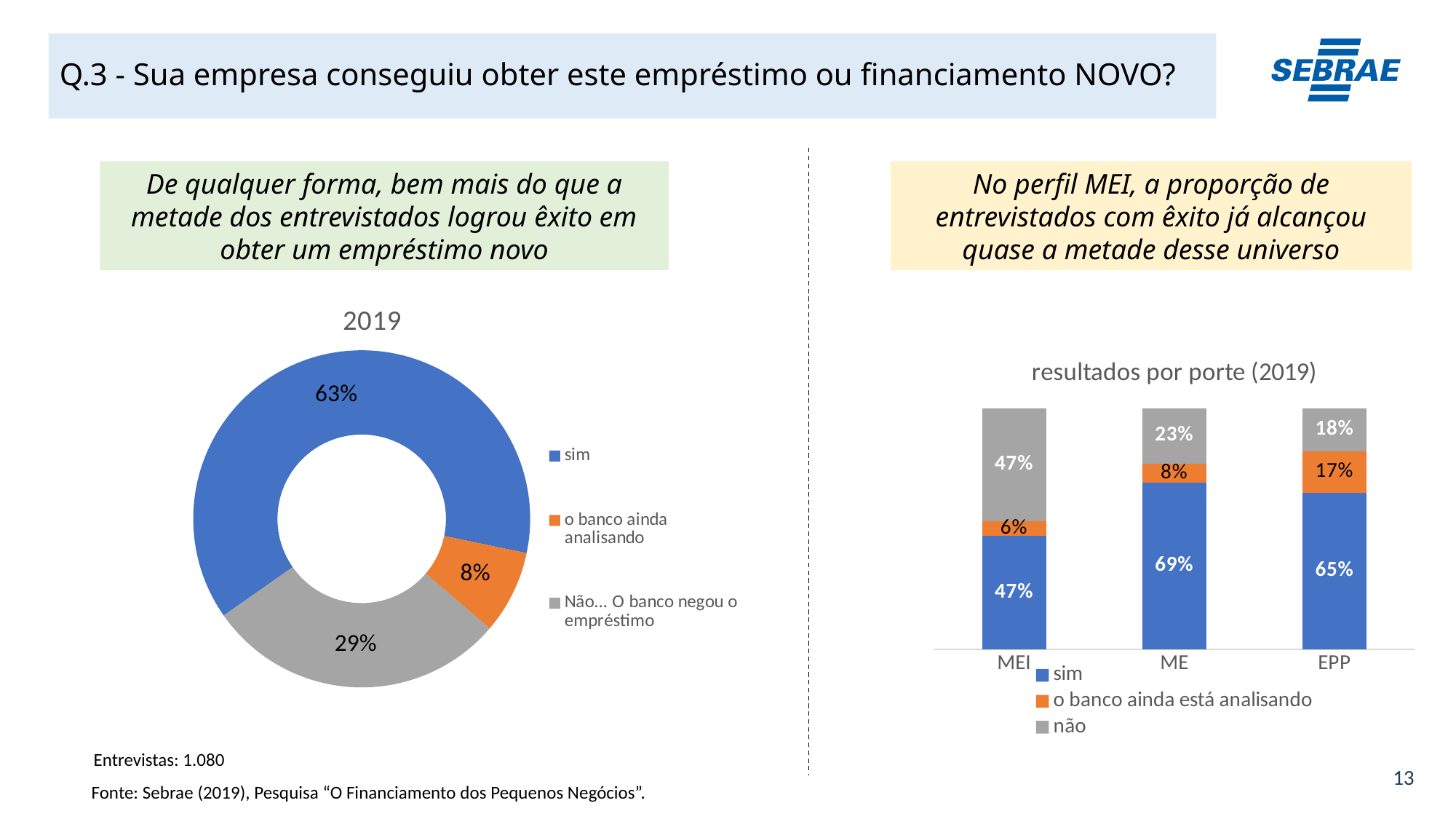
What kind of chart is 'resultados por porte (2019)'? Stacked bar chart In the 'resultados por porte (2019)' chart, what is the difference between the 'sim' values for ME and MEI? 22 percentage points In the 'resultados por porte (2019)' chart, which porte has the highest 'sim' value? ME In the '2019' donut chart, how many categories does the legend list? 3 In the '2019' donut chart, which category has the smallest share? o banco ainda analisando What kind of chart is the '2019' chart on the left? Donut (pie) chart In the '2019' donut chart, what share of respondents answered 'sim'? 63% In the '2019' donut chart, what share corresponds to 'Não... O banco negou o empréstimo'? 29% In the 'resultados por porte (2019)' chart, what is the value of 'não' for ME? 23% In the 'resultados por porte (2019)' chart, how many series does the legend list? 3 In the 'resultados por porte (2019)' chart, is the 'o banco ainda está analisando' value larger for EPP or for ME? EPP In the 'resultados por porte (2019)' chart, what is the value of 'sim' for MEI? 47%